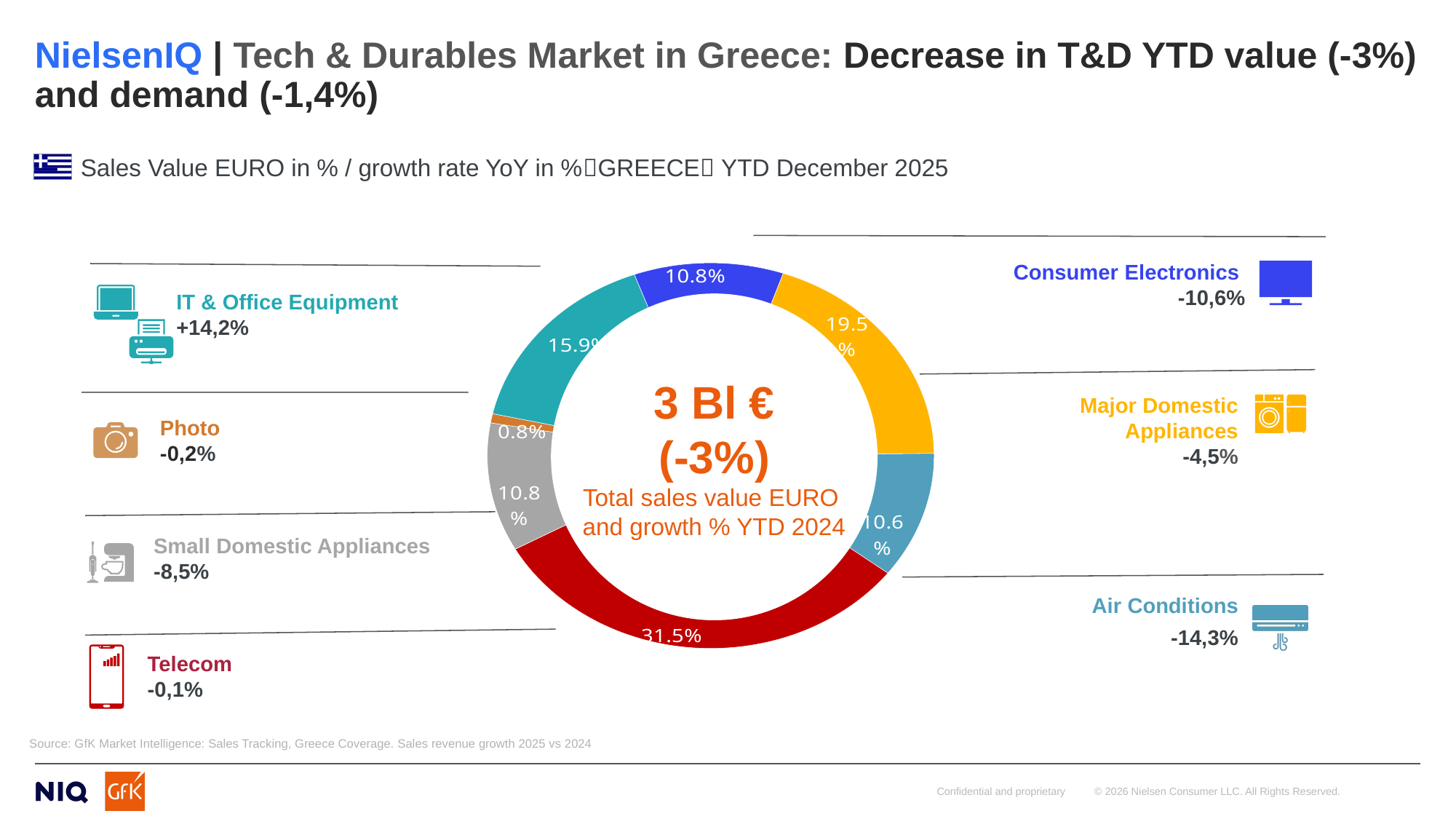
What type of chart is shown on the slide? Donut (pie) chart What share of sales value does Telecom hold in the donut chart? 31.5% What is the YoY growth rate shown for Air Conditions? -14,3% Which category has the smallest share of sales value in the donut chart? Photo What share of sales value does Photo hold in the donut chart? 0.8% What share of sales value does Major Domestic Appliances hold in the donut chart? 19.5% What is the difference in sales value share between Telecom and Major Domestic Appliances? 12 percentage points What total sales value and growth are shown in the centre of the donut chart? 3 Bl € (-3%) Which category has the largest share of sales value in the donut chart? Telecom What share of sales value does IT & Office Equipment hold in the donut chart? 15.9% What is the YoY growth rate shown for IT & Office Equipment? +14,2% How many categories are shown in the donut chart? 7